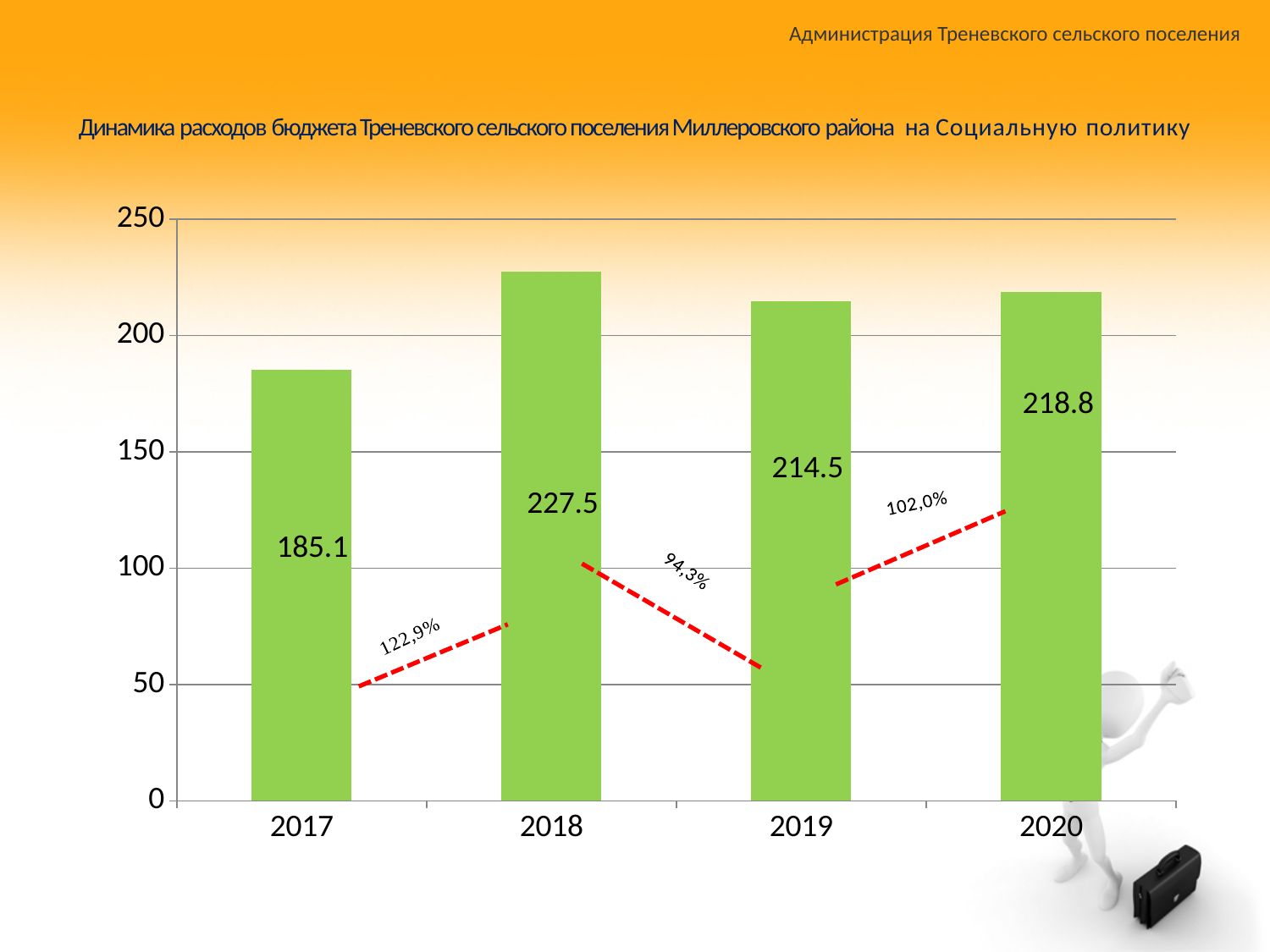
What is the value for 2019? 214.5 Which is larger, the value for 2019 or the value for 2020? 2020 Is the value for 2017 greater or less than 200? less What is the value for 2020? 218.8 What is the value for 2018? 227.5 What kind of chart is this? bar chart What is the value for 2017? 185.1 Which year has the highest value? 2018 How many years are shown on the x axis? 4 What percentage change is labelled between 2018 and 2019? 94,3% Which year has the lowest value? 2017 What is the difference between the values for 2018 and 2017? 42.4